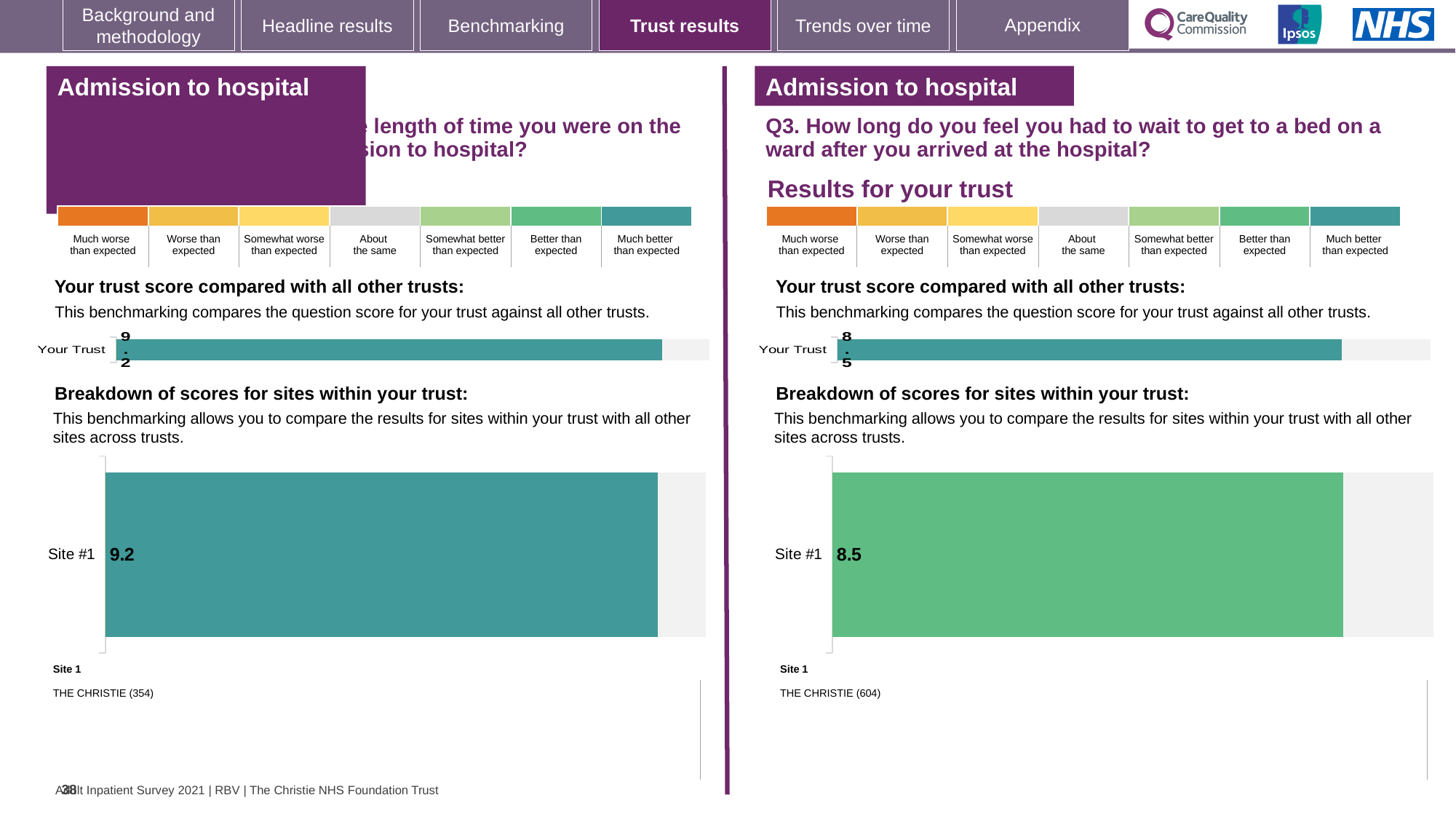
What is the difference between the Site #1 score on the left panel and the Site #1 score on the right panel (Q3)? 0.7 On the right panel (Q3), what is the score shown for 'Your Trust' in the trust score comparison bar? 8.5 How many sites are shown in the breakdown of scores chart on the left panel? 1 How many sites are shown in the breakdown of scores chart on the right panel (Q3)? 1 On the left panel, what is the score shown for Site #1 in the breakdown of scores for sites within your trust? 9.2 On the right panel (Q3, wait to get to a bed on a ward), what is the score shown for Site #1? 8.5 On the left panel, what is the score shown for 'Your Trust' in the trust score comparison bar? 9.2 Which Site #1 score is larger: the one on the left panel or the one on the right panel (Q3)? Left panel On the right panel (Q3), what is the name of Site 1 and its respondent count as listed below the chart? THE CHRISTIE (604) What type of chart is used to show the Site #1 score on the right panel (Q3)? Bar chart On the right panel (Q3), which benchmarking category does the colour of the Site #1 bar correspond to? Better than expected On the left panel, which benchmarking category does the colour of the Site #1 bar correspond to? Much better than expected